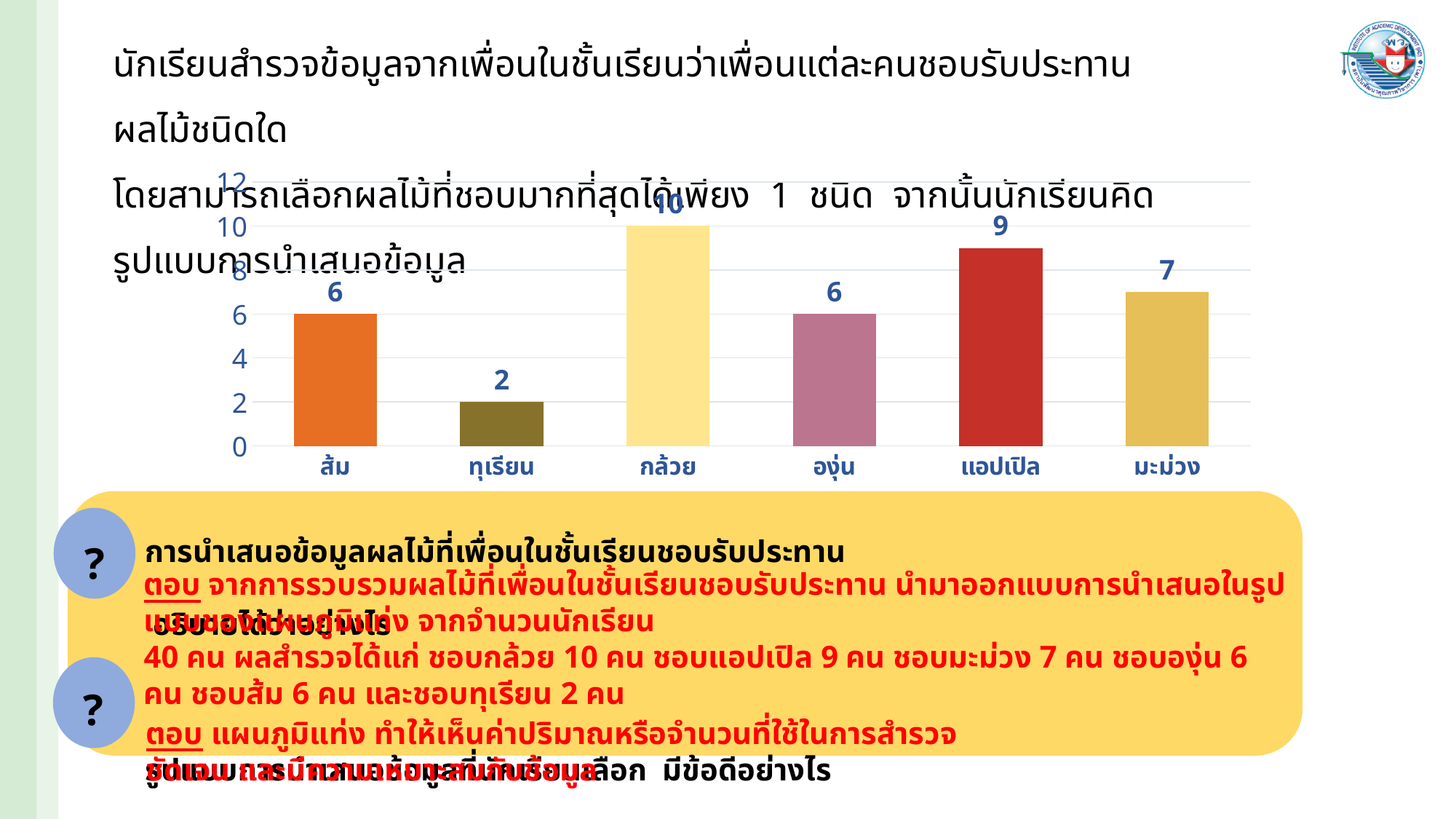
What is the highest tick value shown on the vertical axis? 12 What is the value for ทุเรียน? 2 What is the value for กล้วย? 10 What is the value for มะม่วง? 7 Which is larger, the value for แอปเปิล or the value for มะม่วง? แอปเปิล Which fruit has the lowest value? ทุเรียน Which fruit has the highest value? กล้วย What is the value for แอปเปิล? 9 What type of chart is shown on the slide? bar chart What is the difference between the values for กล้วย and ทุเรียน? 8 What is the difference between the values for แอปเปิล and องุ่น? 3 How many fruit categories are shown in the chart? 6